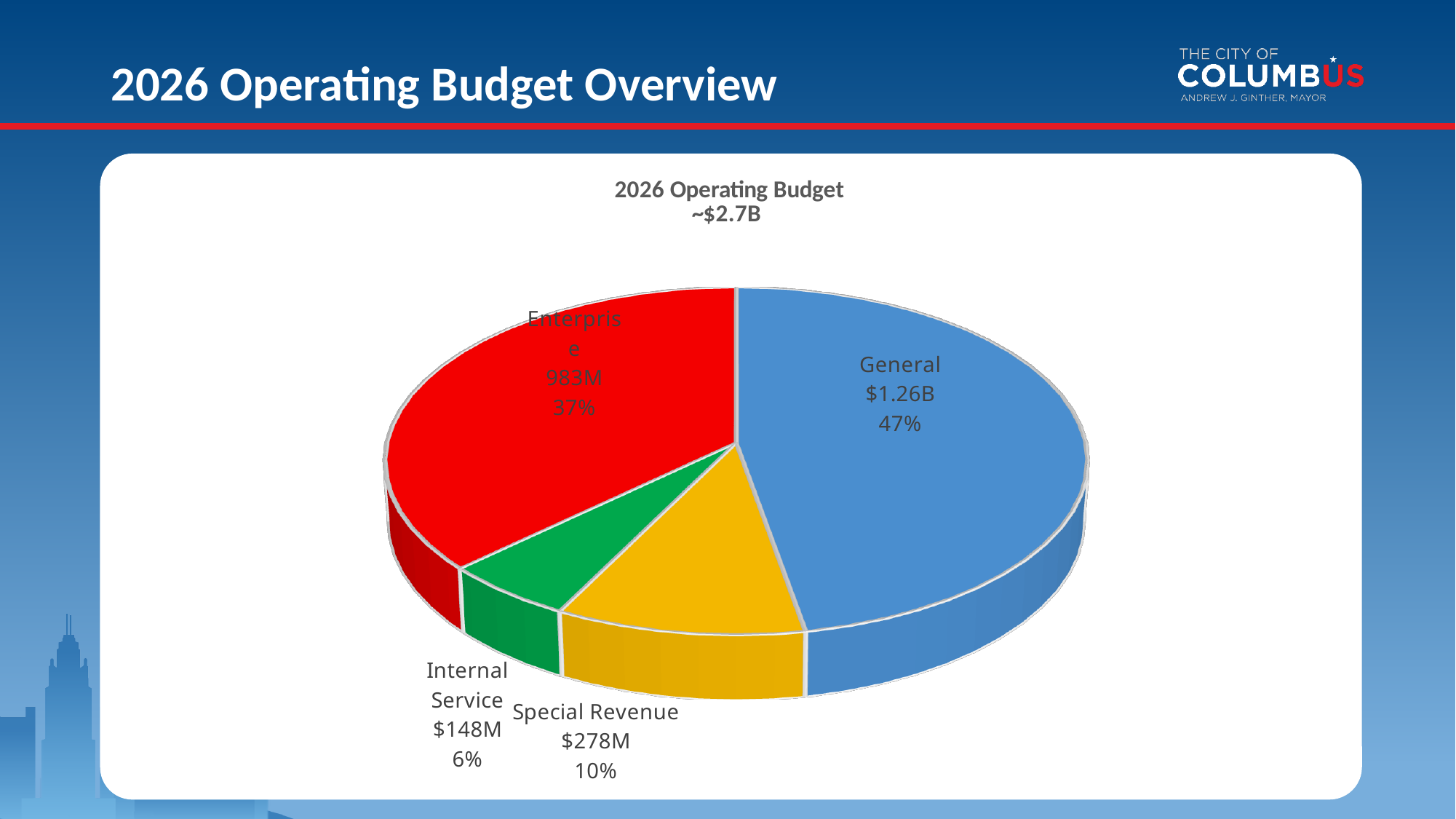
What is the difference in percentage points between the General share and the Enterprise share? 10 percentage points What is the dollar value shown for Special Revenue? $278M What percentage share of the pie does the Enterprise slice represent? 37% What is the dollar value shown for Internal Service? $148M What kind of chart is shown on the slide? Pie chart Which category has the smallest share of the 2026 operating budget? Internal Service What is the title of the pie chart? 2026 Operating Budget ~$2.7B What is the dollar value shown for the General slice? $1.26B Which is larger, the Special Revenue value or the Internal Service value? Special Revenue Which category has the largest share of the 2026 operating budget? General What is the value shown for the Enterprise slice? 983M How many slices does the pie chart have? 4